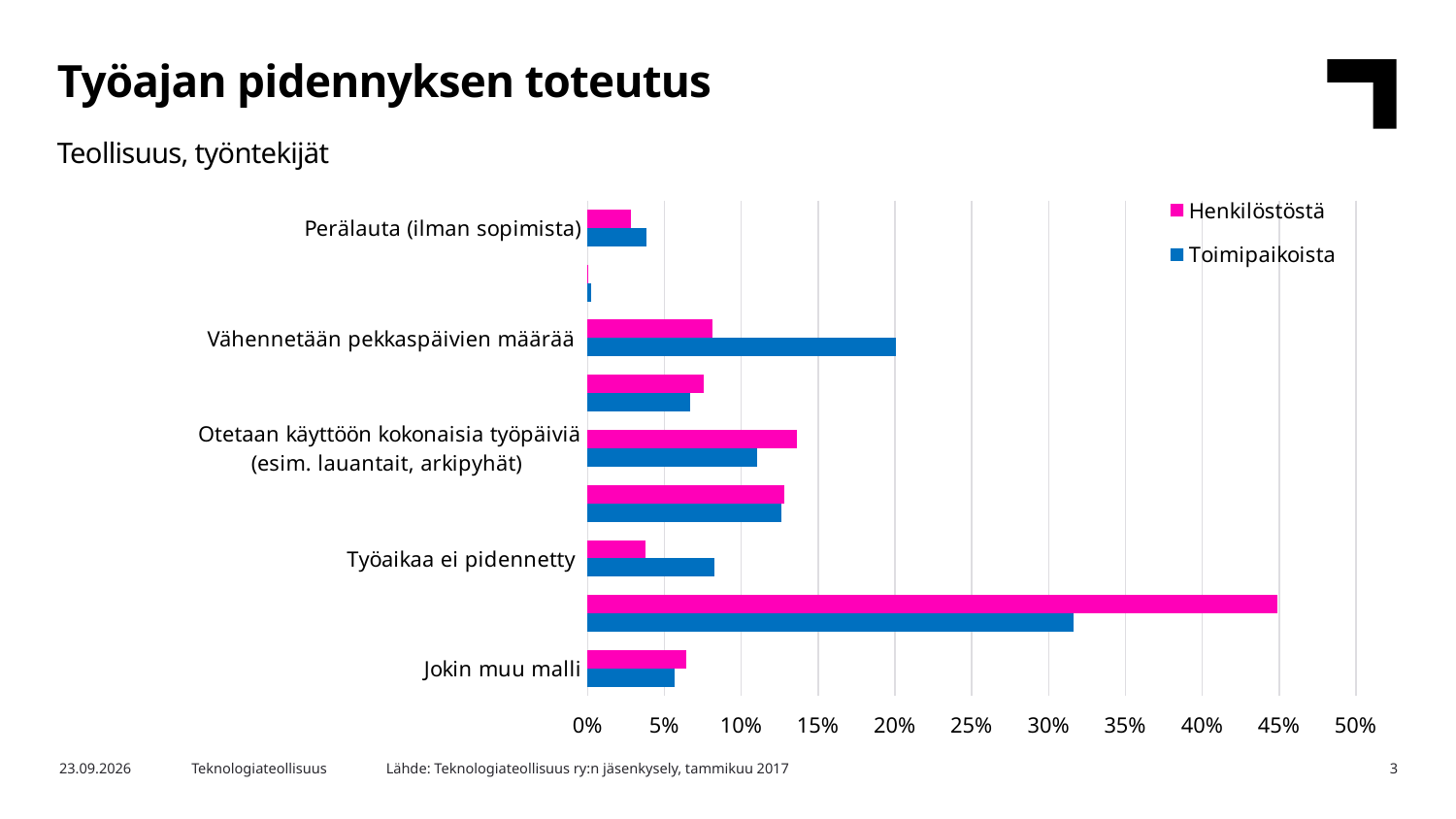
Is the Toimipaikoista value for 'Vähennetään pekkaspäivien määrää' greater or less than 15%? greater Is the Toimipaikoista value for 'Työaikaa ei pidennetty' greater or less than 5%? greater For 'Työaikaa ei pidennetty', which series has the larger value, Henkilöstöstä or Toimipaikoista? Toimipaikoista For 'Vähennetään pekkaspäivien määrää', which series has the larger value, Henkilöstöstä or Toimipaikoista? Toimipaikoista How many series does the legend list? 2 Is the Henkilöstöstä value for 'Otetaan käyttöön kokonaisia työpäiviä (esim. lauantait, arkipyhät)' greater or less than 10%? greater What is the title of the slide containing the chart? Työajan pidennyksen toteutus What kind of chart is shown on the slide? Bar chart For 'Otetaan käyttöön kokonaisia työpäiviä (esim. lauantait, arkipyhät)', which series has the larger value, Henkilöstöstä or Toimipaikoista? Henkilöstöstä Which series is shown in magenta (pink) in the chart? Henkilöstöstä